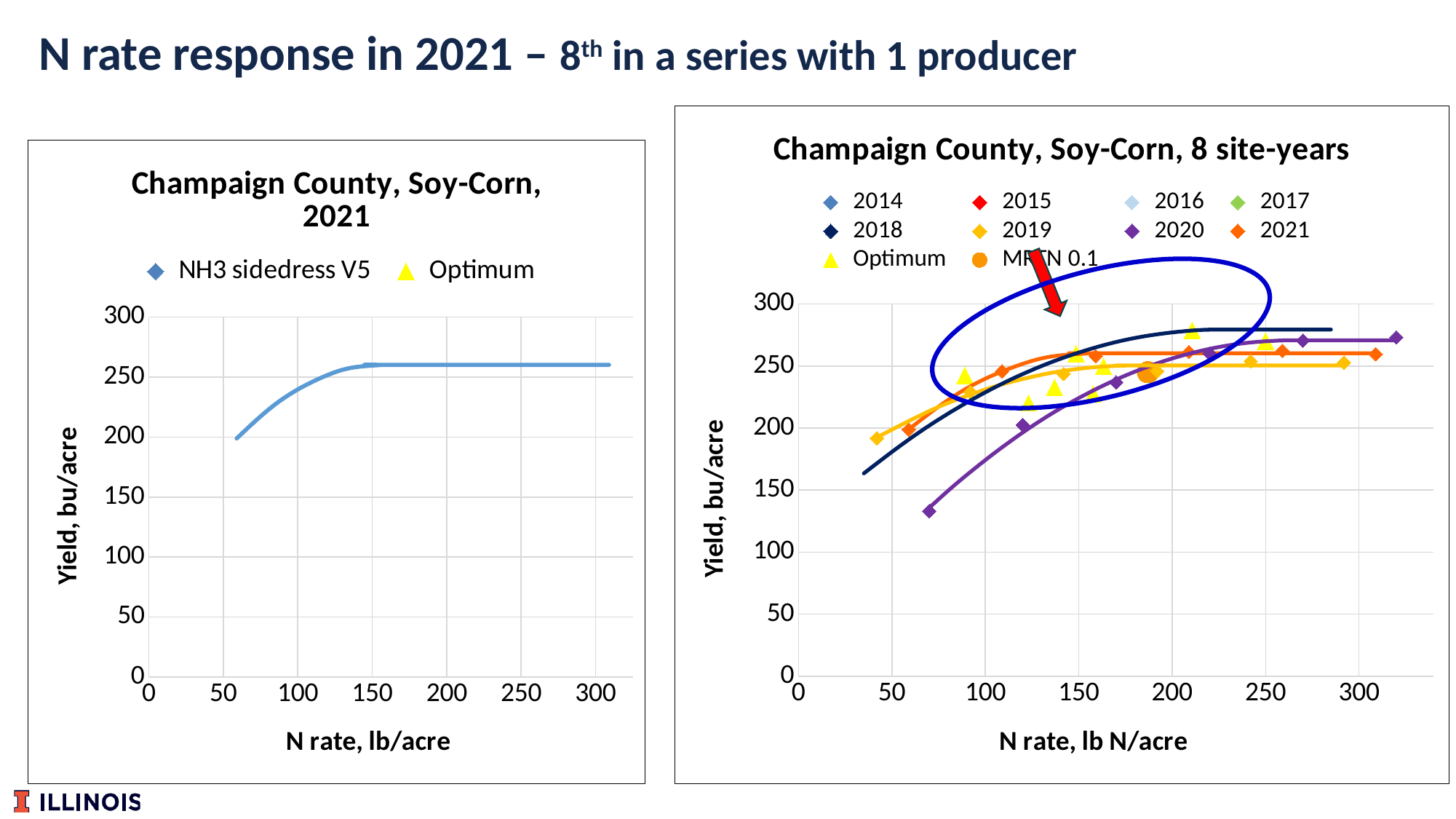
In the left chart, "Champaign County, Soy-Corn, 2021", is the yield at an N rate of 300 lb/acre greater or less than 250? greater In the right chart, "Champaign County, Soy-Corn, 8 site-years", which is lower: the lowest 2020 data point or the lowest 2019 data point? 2020 In the right chart, "Champaign County, Soy-Corn, 8 site-years", is the 2020 data point at about 320 lb N/acre greater or less than 250 bu/acre? greater What is the y-axis label of the left chart, "Champaign County, Soy-Corn, 2021"? Yield, bu/acre How many entries does the legend of the right chart, "Champaign County, Soy-Corn, 8 site-years", list? 10 In the right chart, "Champaign County, Soy-Corn, 8 site-years", is the 2019 data point at about 40 lb N/acre greater or less than 200 bu/acre? less What is the x-axis label of the right chart, "Champaign County, Soy-Corn, 8 site-years"? N rate, lb N/acre How many entries does the legend of the left chart, "Champaign County, Soy-Corn, 2021", list? 2 In the left chart, "Champaign County, Soy-Corn, 2021", does yield rise or fall as N rate increases from 50 to 150 lb/acre? rise What kind of chart is the left chart titled "Champaign County, Soy-Corn, 2021"? Line chart